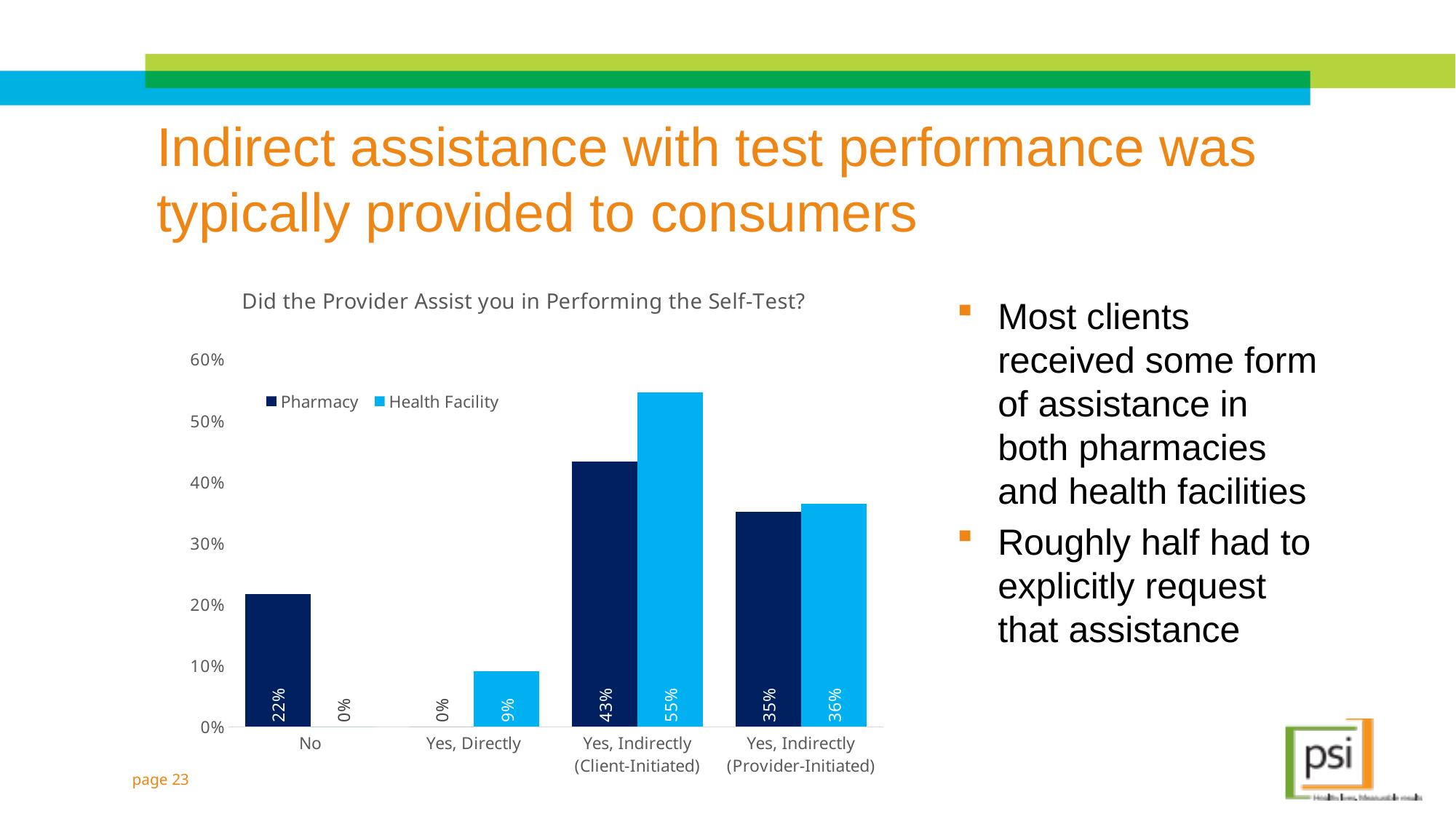
What is the Pharmacy value for "Yes, Indirectly (Provider-Initiated)"? 35% Is the Pharmacy value for "Yes, Indirectly (Client-Initiated)" greater or less than 40%? greater How many series does the legend list? 2 What is the Health Facility value for "Yes, Indirectly (Client-Initiated)"? 55% What is the Health Facility value for "Yes, Directly"? 9% What type of chart is shown on the slide? Bar chart Which category has the highest Health Facility value? Yes, Indirectly (Client-Initiated) What is the difference between the Health Facility and Pharmacy values for "Yes, Indirectly (Client-Initiated)"? 12% For the "No" category, which series has the larger value, Pharmacy or Health Facility? Pharmacy What is the Pharmacy value for the "No" category? 22% Which category has the lowest Pharmacy value? Yes, Directly How many categories are shown on the x axis? 4